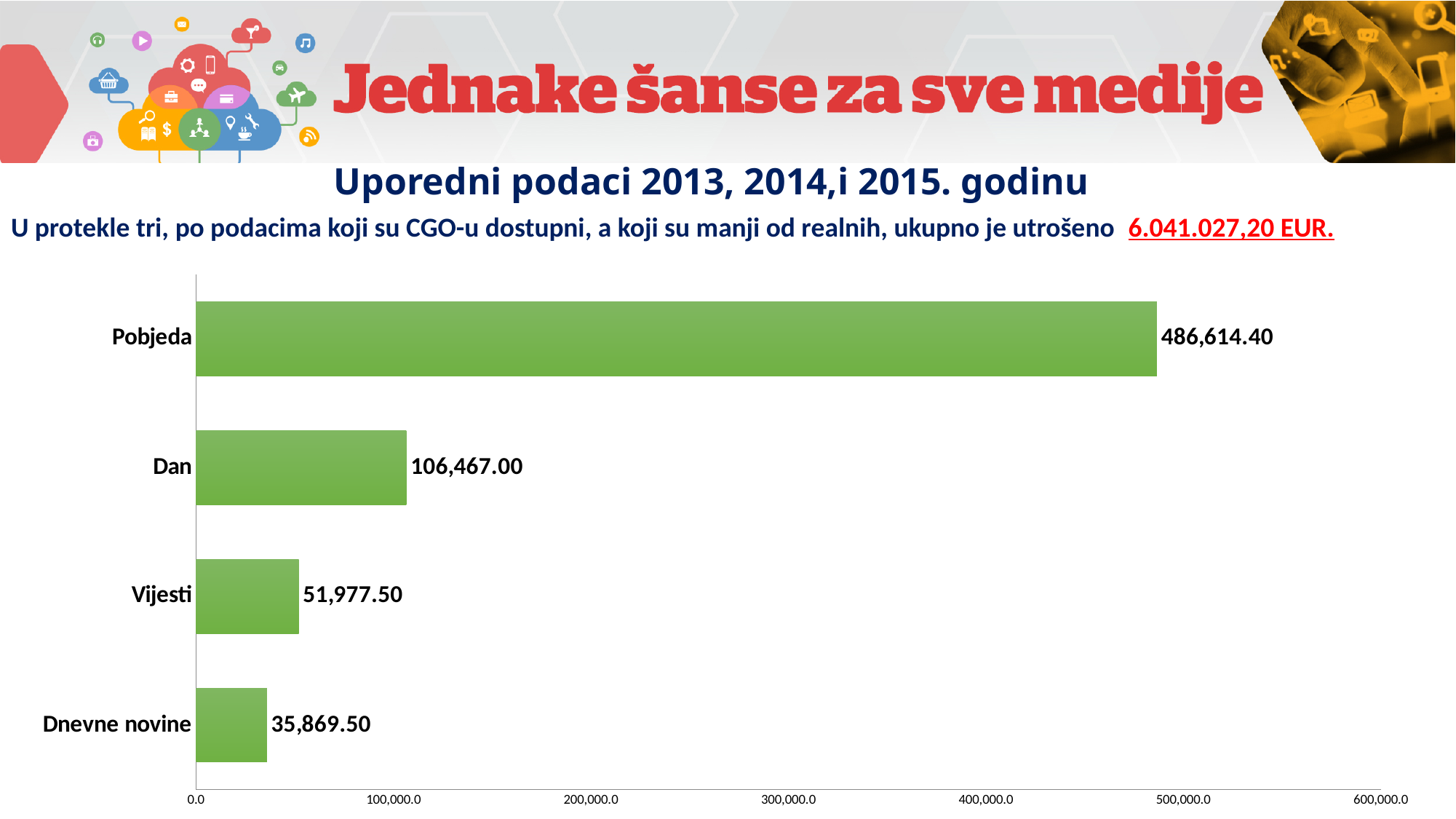
What is the value for Dnevne novine? 35,869.50 Is the value for Pobjeda greater or less than 400,000.0? greater Which is larger, the value for Dan or the value for Vijesti? Dan What is the value for Dan? 106,467.00 What is the difference between the values for Pobjeda and Dan? 380,147.40 What is the value for Vijesti? 51,977.50 What is the value for Pobjeda? 486,614.40 Which category has the highest value? Pobjeda What kind of chart is shown on the slide? bar chart What is the difference between the values for Vijesti and Dnevne novine? 16,108.00 Which category has the lowest value? Dnevne novine How many categories are shown in the chart? 4